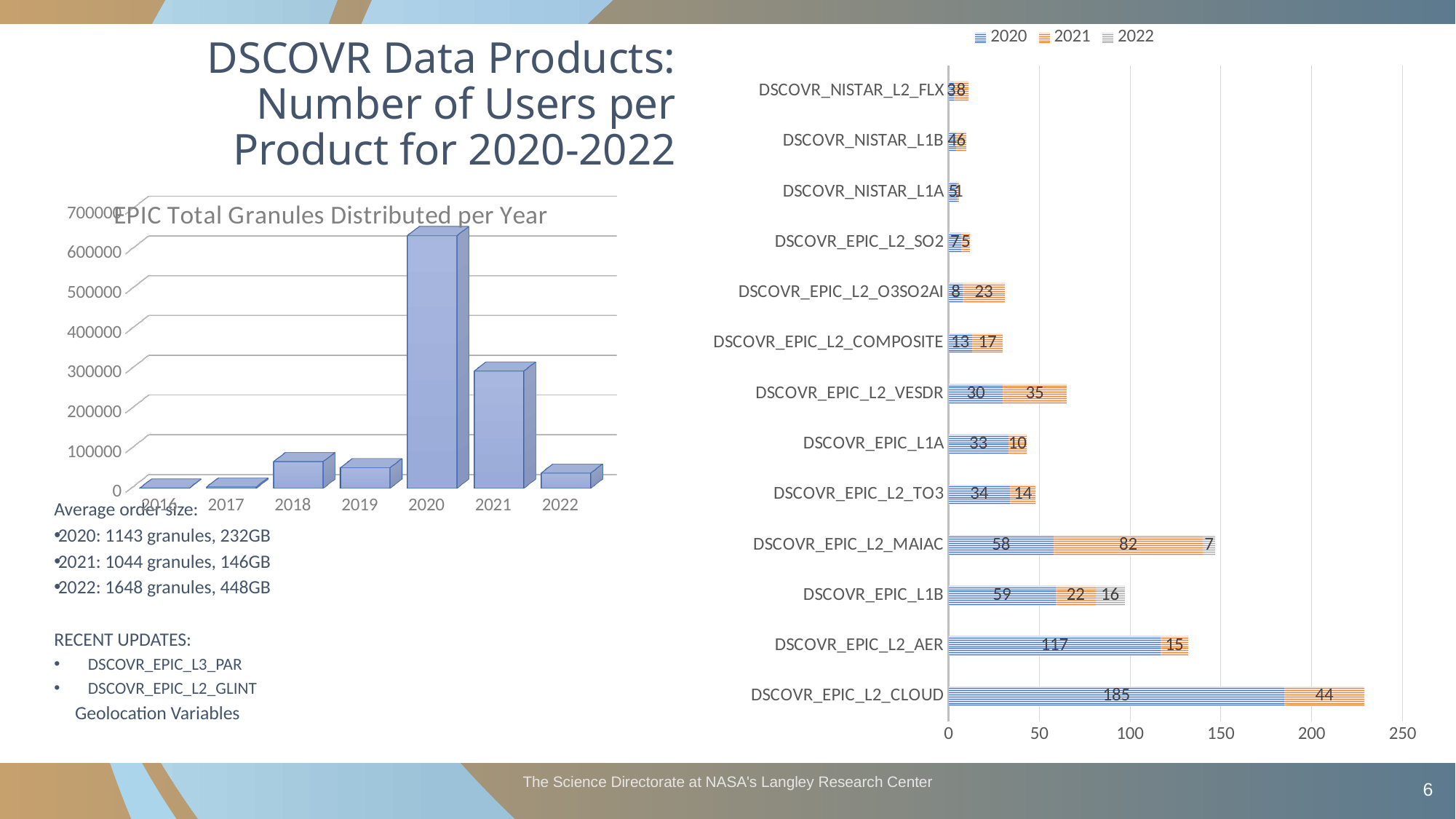
How many products are shown in the chart on the right? 13 What kind of chart is 'EPIC Total Granules Distributed per Year'? bar chart How many series does the legend of the chart on the right list? 3 In the chart on the right, how many users did DSCOVR_EPIC_L2_MAIAC have in 2021? 82 In the chart titled 'EPIC Total Granules Distributed per Year', is the value for 2021 greater or less than 200000? greater In the chart on the right, how many users did DSCOVR_EPIC_L2_CLOUD have in 2020? 185 In the chart on the right, which had more users in 2021: DSCOVR_EPIC_L2_VESDR or DSCOVR_EPIC_L2_TO3? DSCOVR_EPIC_L2_VESDR In the chart on the right, what is the total number of users across all three years for DSCOVR_EPIC_L1B? 97 In the chart on the right, which product had the most users in 2020? DSCOVR_EPIC_L2_CLOUD In the chart on the right, how many users did DSCOVR_EPIC_L1B have in 2022? 16 In the chart titled 'EPIC Total Granules Distributed per Year', which year has the highest value? 2020 In the chart on the right, what is the difference between the 2020 and 2021 user counts for DSCOVR_EPIC_L2_AER? 102